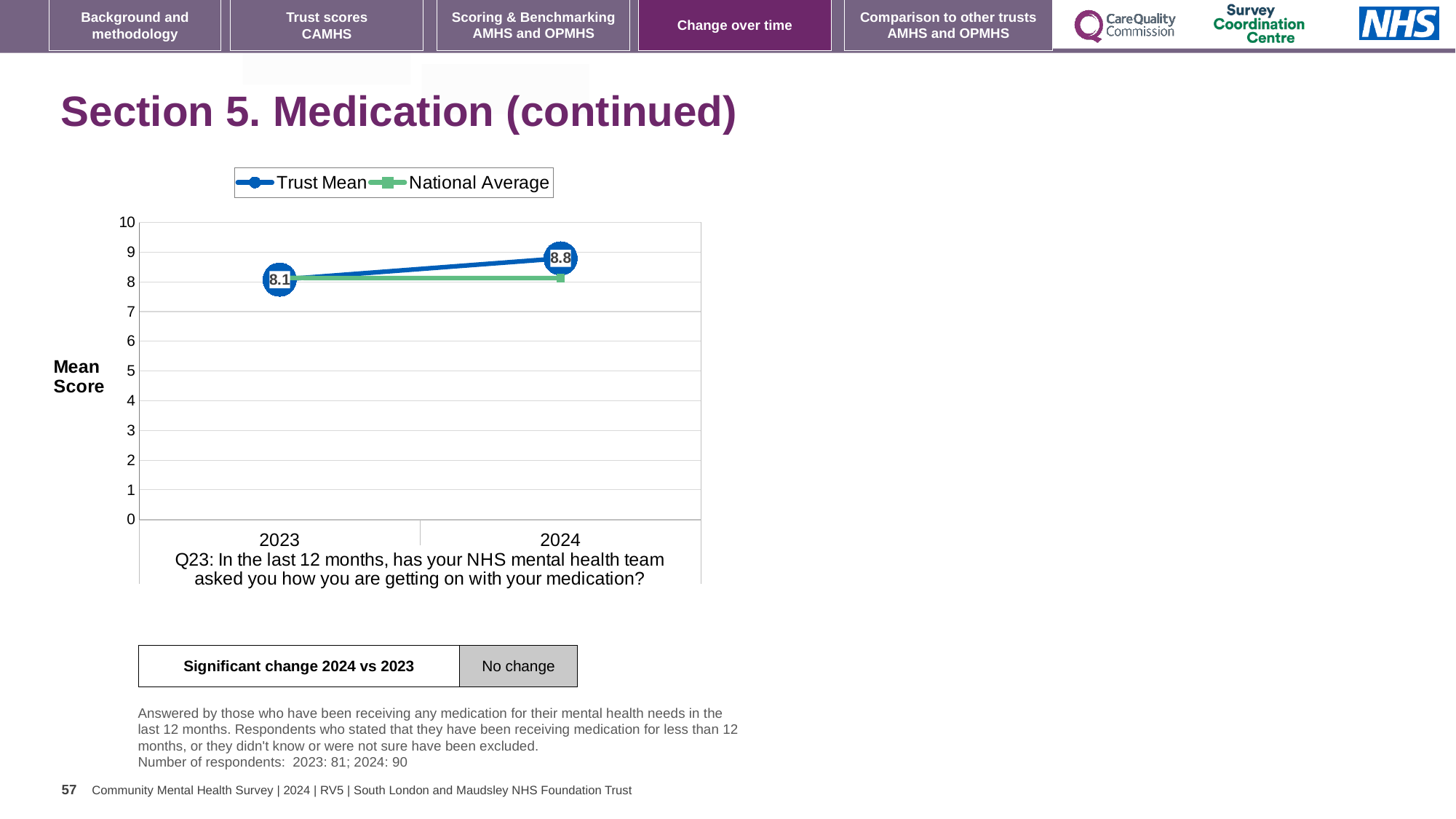
What kind of chart is shown? line chart Is the National Average for 2023 greater or less than 9? less In which year is the Trust Mean higher, 2023 or 2024? 2024 Does the Trust Mean rise or fall from 2023 to 2024? rise How many years are shown on the x axis? 2 What is the Trust Mean score for 2023? 8.1 What is the Trust Mean score for 2024? 8.8 In 2024, which is larger, the Trust Mean or the National Average? Trust Mean Is the National Average for 2024 greater or less than 7? greater What is the label on the y axis? Mean Score By how much did the Trust Mean change from 2023 to 2024? 0.7 How many series does the legend list? 2